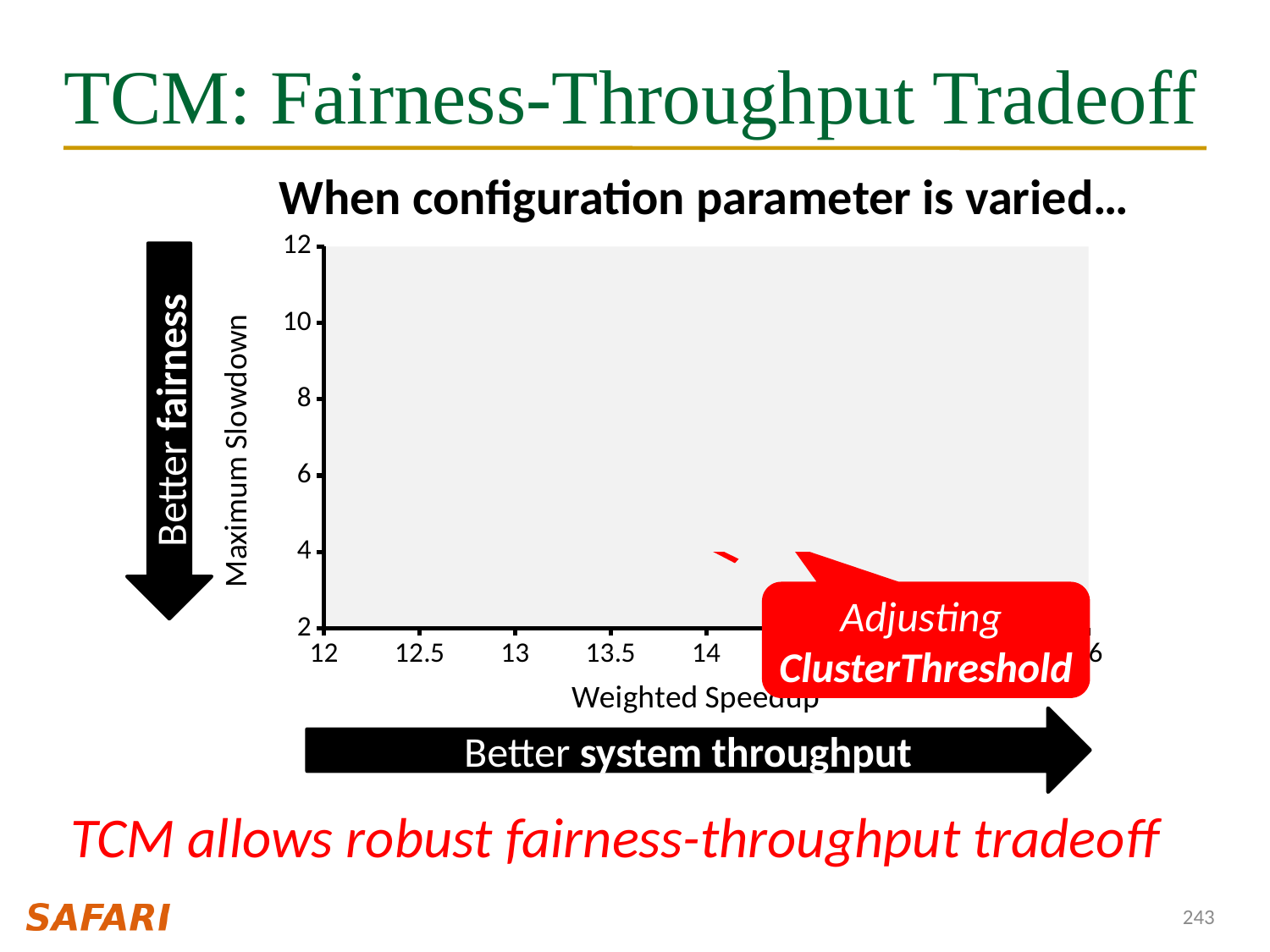
What is the label of the y axis of the chart? Maximum Slowdown Is the Weighted Speedup of the visible red data point greater or less than 15? less Is the Maximum Slowdown of the visible red data point greater or less than 2? greater Is the Maximum Slowdown of the visible red data point greater or less than 6? less What is the label of the x axis of the chart? Weighted Speedup